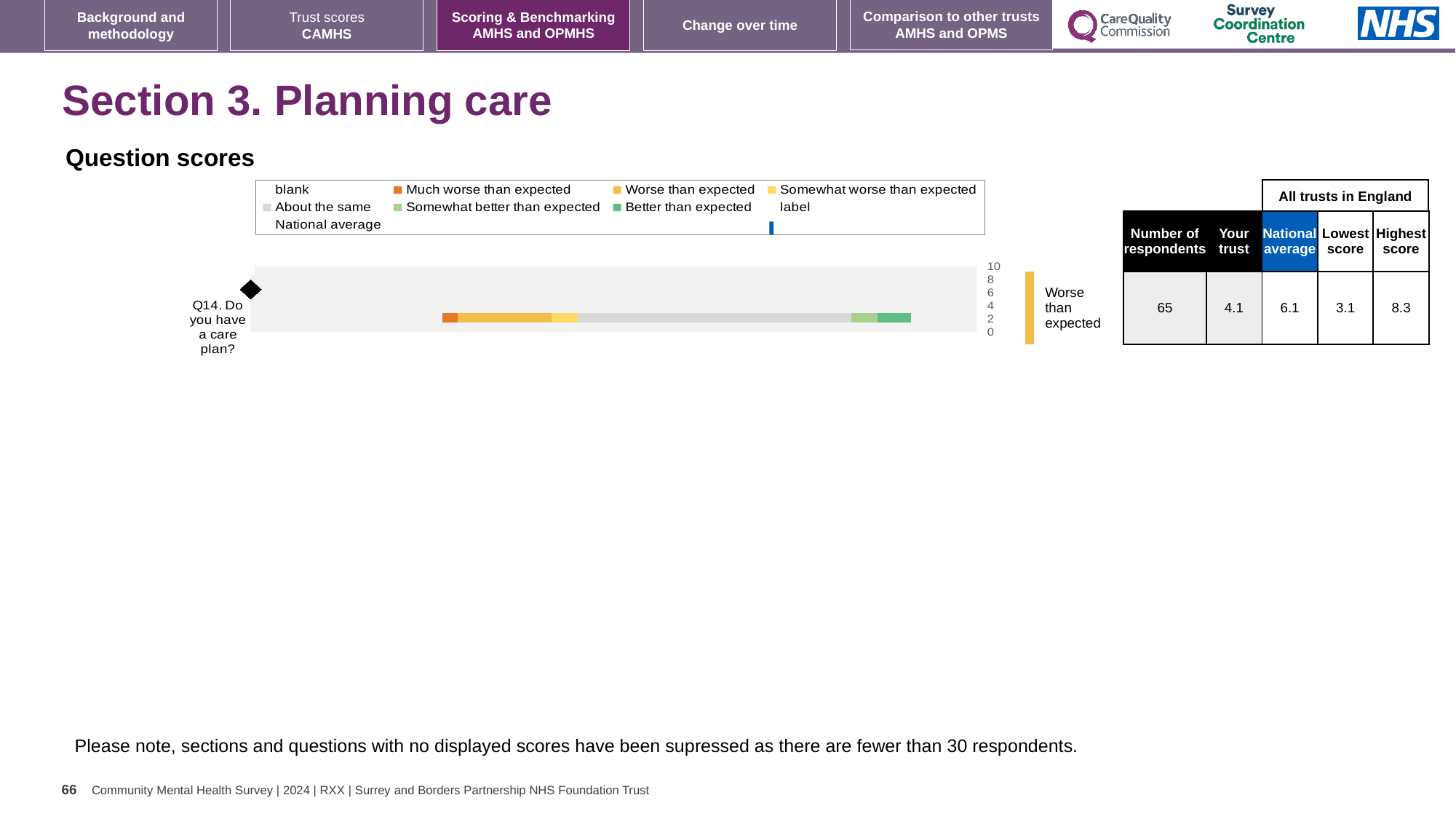
What is the highest score among all trusts in England for Q14? 8.3 What is the difference between the highest and lowest scores for Q14 across all trusts in England? 5.2 What benchmark rating label is shown next to the Q14 bar? Worse than expected Which is larger for Q14, the 'Your trust' score or the national average? National average What is the 'Your trust' score for Q14? 4.1 What is the national average score for Q14? 6.1 What is the lowest score among all trusts in England for Q14? 3.1 How many questions are plotted in the Question scores chart? 1 Which question is shown in the Question scores chart? Q14. Do you have a care plan? What kind of chart is used to show the Q14 question score? bar chart How many respondents answered Q14? 65 What is the difference between the national average and the 'Your trust' score for Q14? 2.0